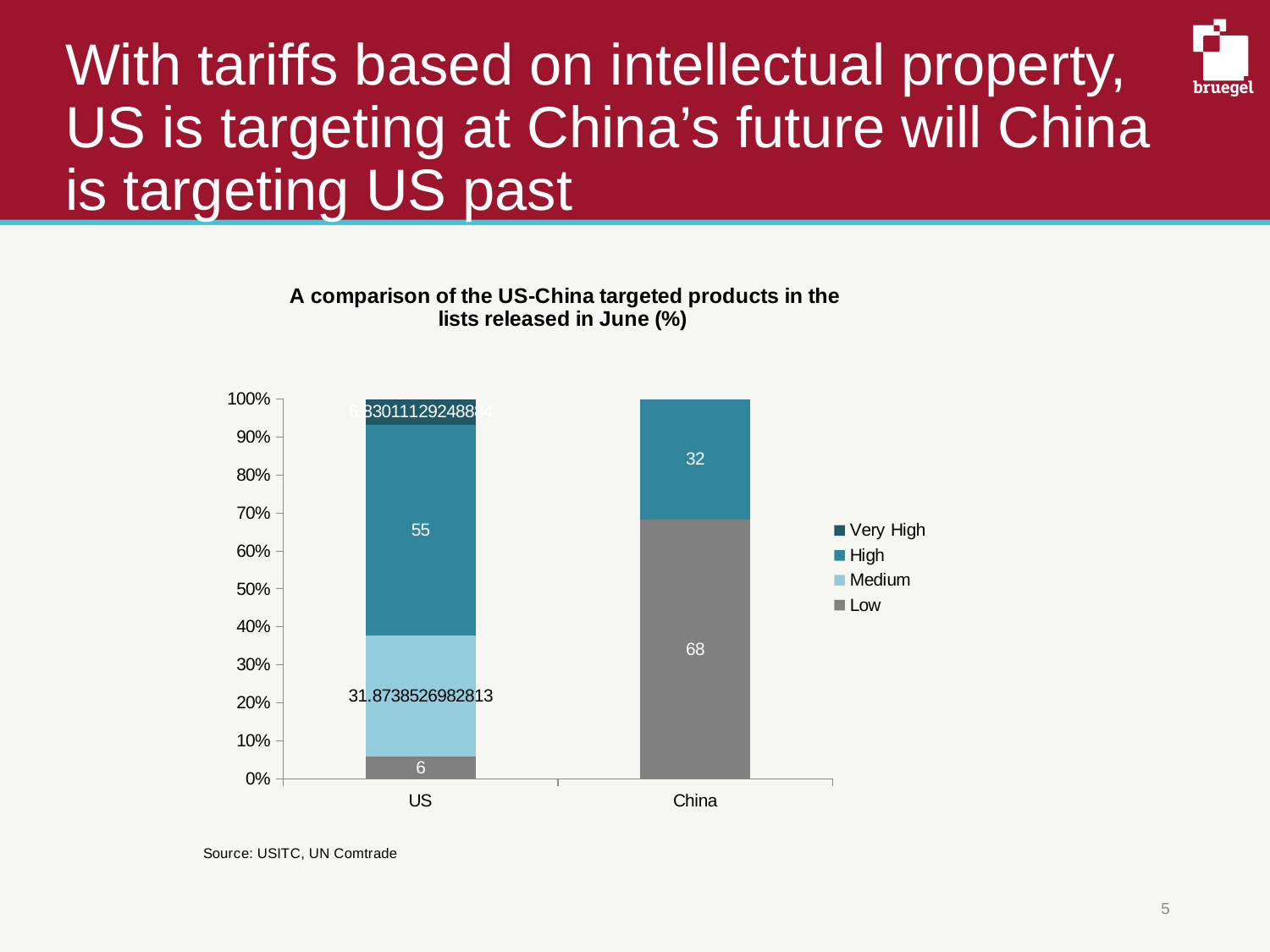
What is the difference between the Low and High segments for China? 36 Is the Medium segment for the US greater or less than 30? greater What kind of chart is shown on the slide? Stacked bar chart What is the value of the High segment for the US? 55 What is the value of the Low segment for China? 68 Which country has the larger Low segment, US or China? China What is the difference between the High segment for the US and the High segment for China? 23 How many series does the legend list? 4 What is the value of the High segment for China? 32 What is the title of the chart? A comparison of the US-China targeted products in the lists released in June (%) What is the value of the Low segment for the US? 6 How many categories are shown on the x axis? 2